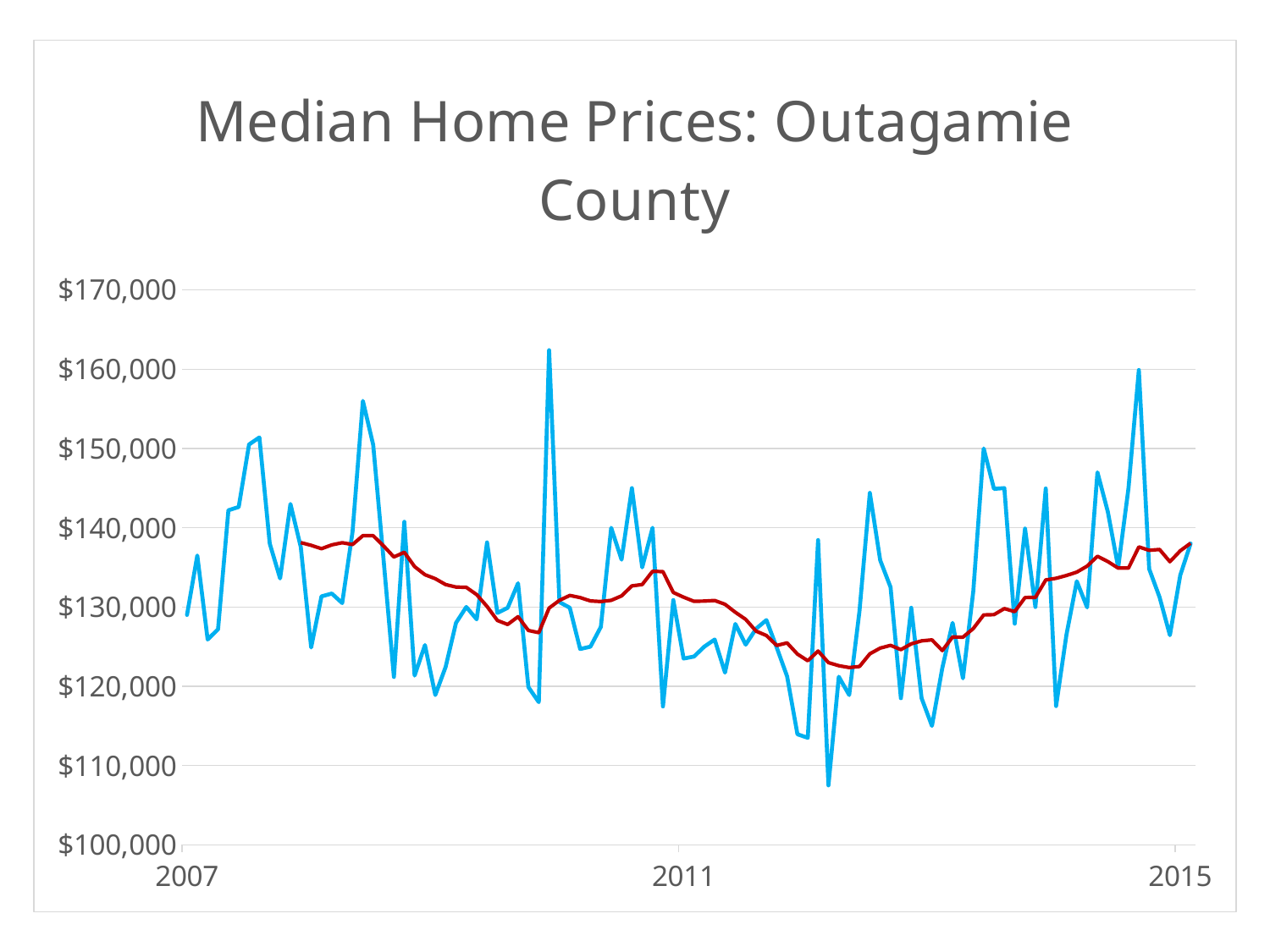
Is the highest peak of the blue line greater or less than $160,000? greater Is the value of the red line at 2015 greater or less than $140,000? less Which line is smoother, the blue line or the red line? the red line Is the lowest point of the red line, around 2012, greater or less than $130,000? less What kind of chart is shown on the slide? line chart How many lines are plotted on the chart? 2 Does the red line rise or fall between 2011 and 2012? fall How many year labels are shown on the horizontal axis? 3 What is the highest value shown on the vertical axis? $170,000 What is the title of the chart? Median Home Prices: Outagamie County Does the red line rise or fall between 2013 and 2015? rise